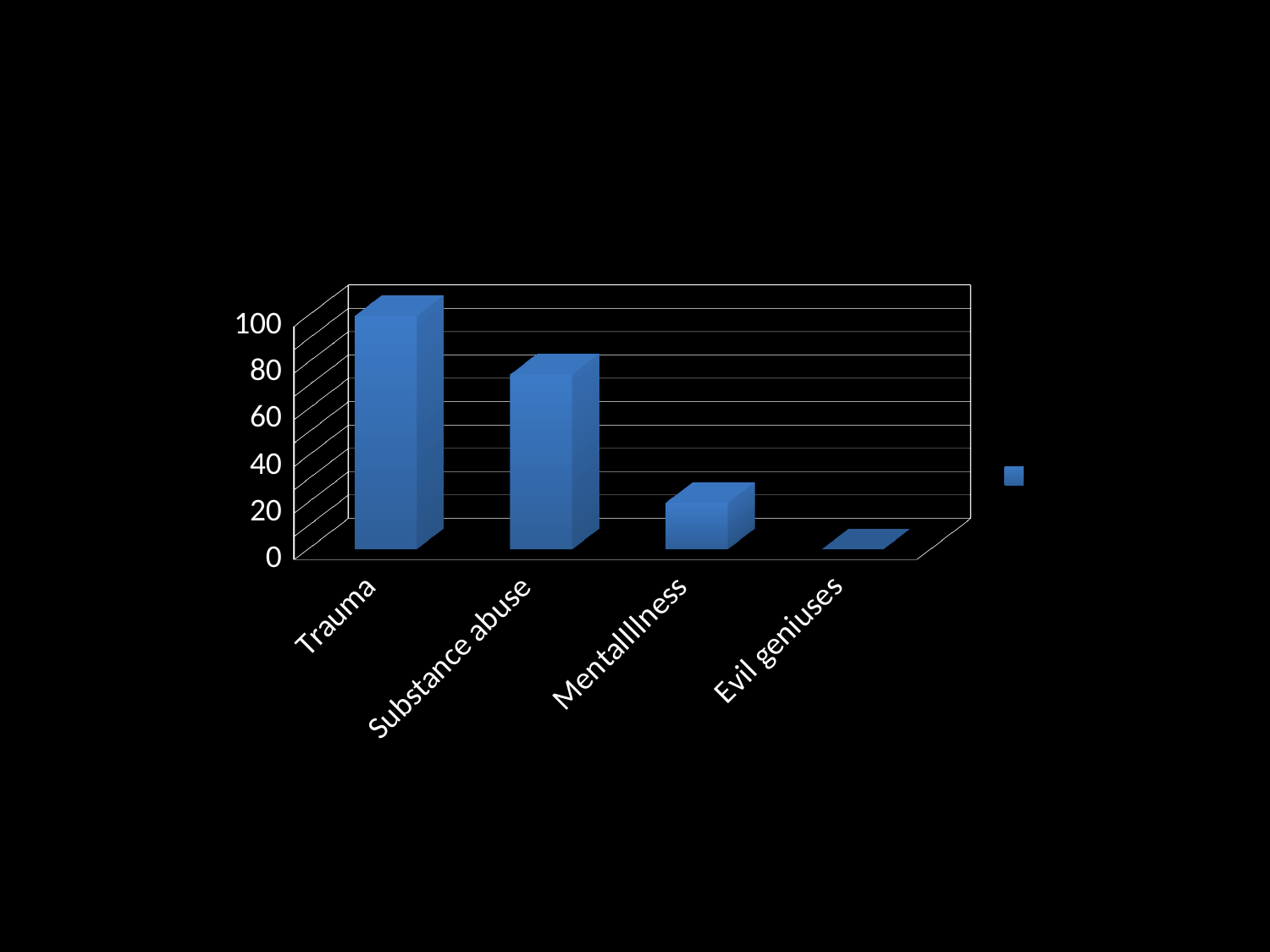
How many series does the legend list? 1 Which category has the lowest bar? Evil geniuses Which category has the highest bar? Trauma Which is larger, the value for MentalIllness or the value for Substance abuse? Substance abuse What kind of chart is shown on the slide? bar chart How many categories are shown on the x axis of the chart? 4 Is the value for Evil geniuses greater or less than 20? less Is the value for Substance abuse greater or less than 60? greater Which is larger, the value for Trauma or the value for Substance abuse? Trauma Is the value for MentalIllness greater or less than 40? less Do the bar values rise or fall from left to right along the x axis? fall